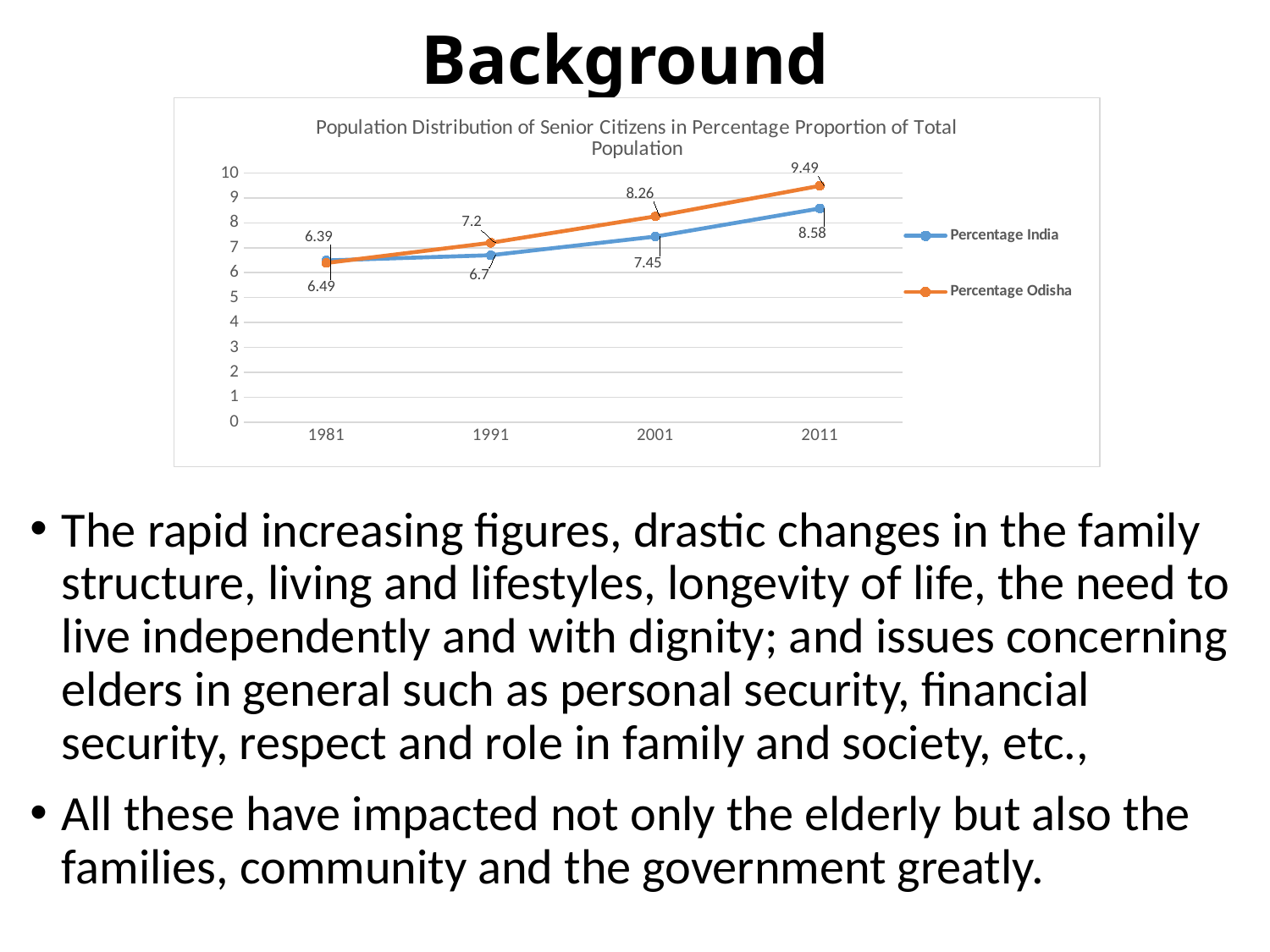
In which year is Percentage India lowest? 1981 What is the value for Percentage Odisha in 2011? 9.49 What is the value for Percentage India in 2011? 8.58 How many series does the legend list? 2 What is the value for Percentage Odisha in 1991? 7.2 What is the difference between Percentage Odisha and Percentage India in 2011? 0.91 In which year is Percentage Odisha highest? 2011 What is the value for Percentage India in 2001? 7.45 Do the values for Percentage India rise or fall from 1981 to 2011? Rise How many years are shown on the x axis? 4 In 2001, which series has the larger value, Percentage India or Percentage Odisha? Percentage Odisha What kind of chart is shown on the slide? Line chart